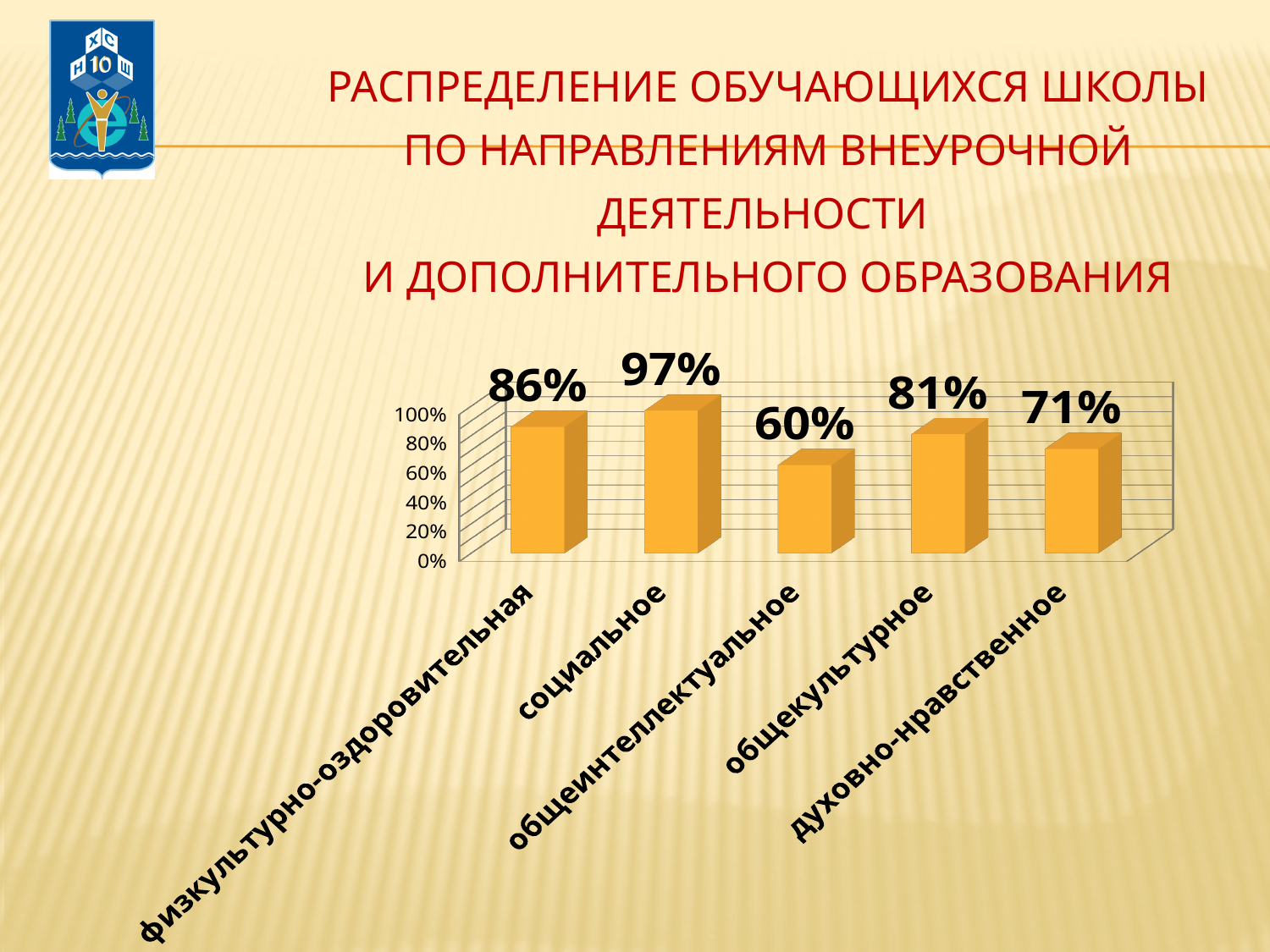
What kind of chart is shown on the slide? bar chart What is the value for духовно-нравственное? 71% Which is larger, the value for общекультурное or the value for духовно-нравственное? общекультурное What is the value for физкультурно-оздоровительная? 86% How many categories are shown in the chart? 5 What is the difference between the values for социальное and общеинтеллектуальное? 37% What is the difference between the values for физкультурно-оздоровительная and общекультурное? 5% Which category has the highest value? социальное What is the value for общеинтеллектуальное? 60% Which category has the lowest value? общеинтеллектуальное What is the maximum value shown on the vertical axis? 100% What is the value for социальное? 97%